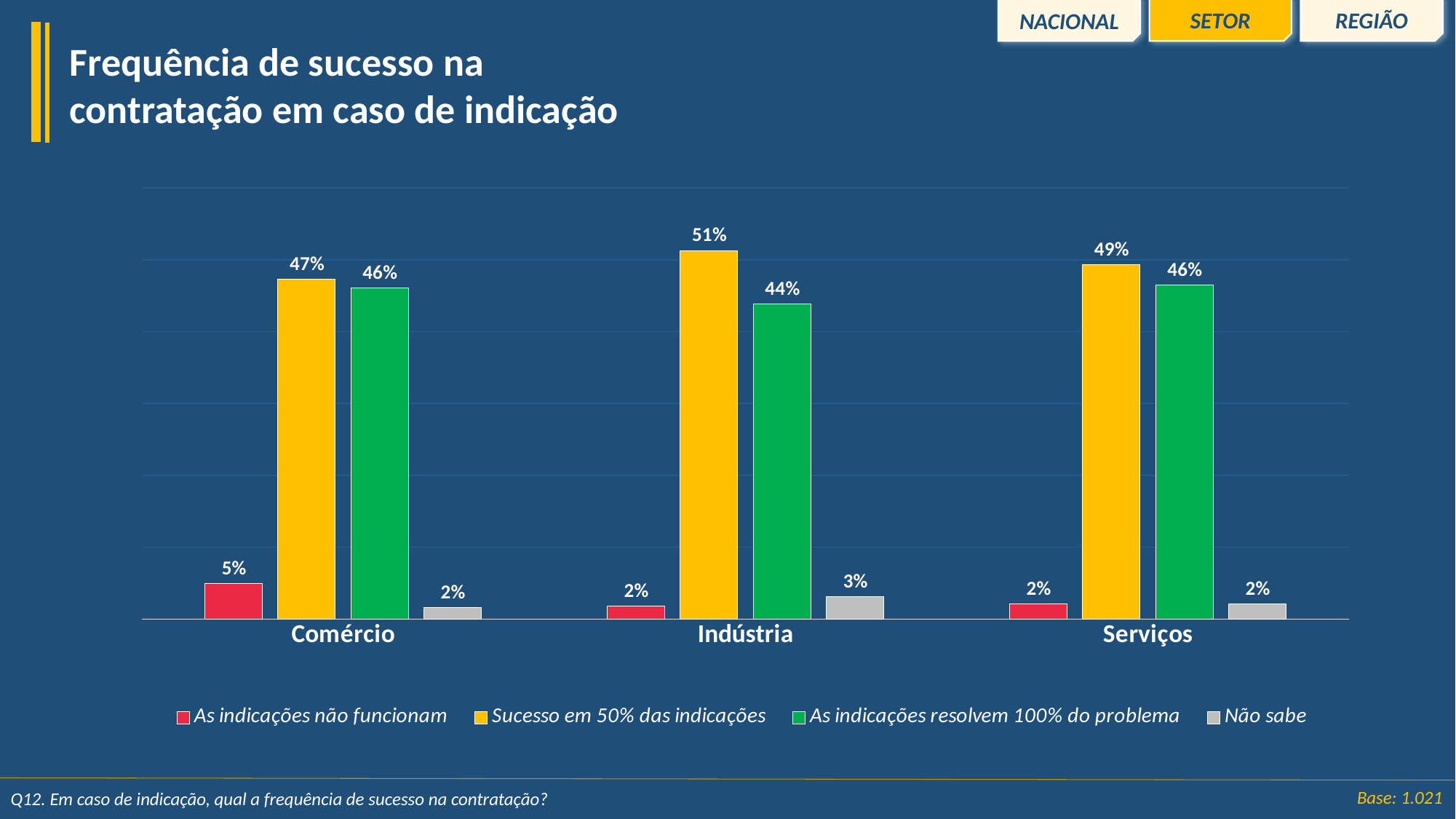
What is the value for 'Sucesso em 50% das indicações' in Indústria? 51% Which is larger in Serviços: 'Sucesso em 50% das indicações' or 'As indicações resolvem 100% do problema'? Sucesso em 50% das indicações How many series does the legend list? 4 What kind of chart is shown on the slide? Bar chart What is the difference between 'Sucesso em 50% das indicações' and 'As indicações resolvem 100% do problema' in Indústria? 7% What is the value for 'Não sabe' in Indústria? 3% What colour represents the 'Não sabe' series? Grey What is the value for 'As indicações não funcionam' in Comércio? 5% What is the value for 'As indicações resolvem 100% do problema' in Serviços? 46% Which sector has the lowest value for 'As indicações resolvem 100% do problema'? Indústria How many sectors are shown on the x axis? 3 Which sector has the highest value for 'Sucesso em 50% das indicações'? Indústria